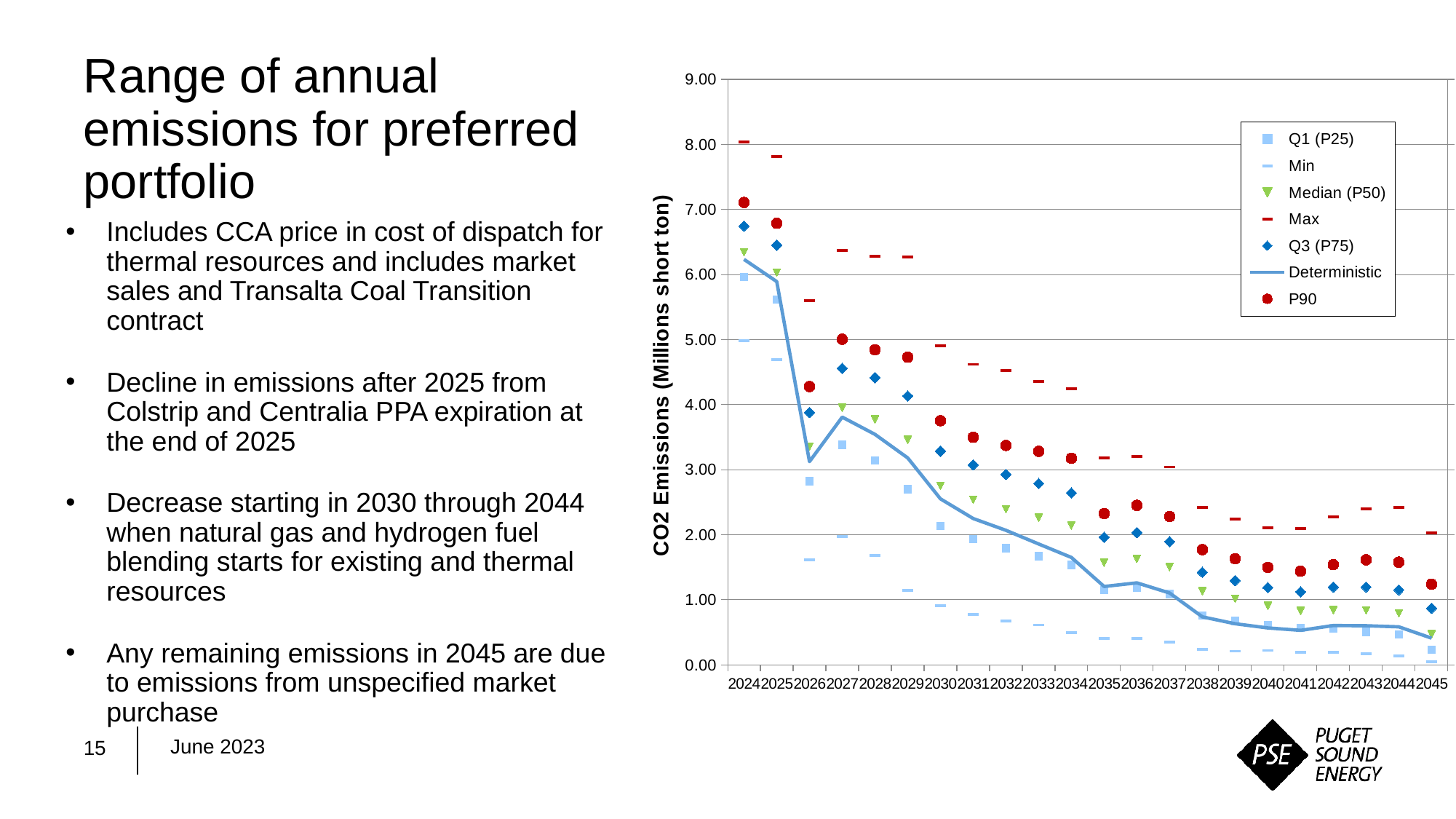
How many years are shown along the x axis of the chart? 22 Is the Q1 (P25) value for 2045 greater or less than 1.00? less Is the Min value for 2024 greater or less than 4.00? greater Does the Deterministic series generally rise or fall from 2024 to 2045? fall In which year is the Max series at its highest? 2024 Is the P90 value for 2024 greater or less than 6.00? greater What is the title of the chart's vertical axis? CO2 Emissions (Millions short ton) Which legend entry is drawn as a solid line rather than markers? Deterministic How many series does the chart legend list? 7